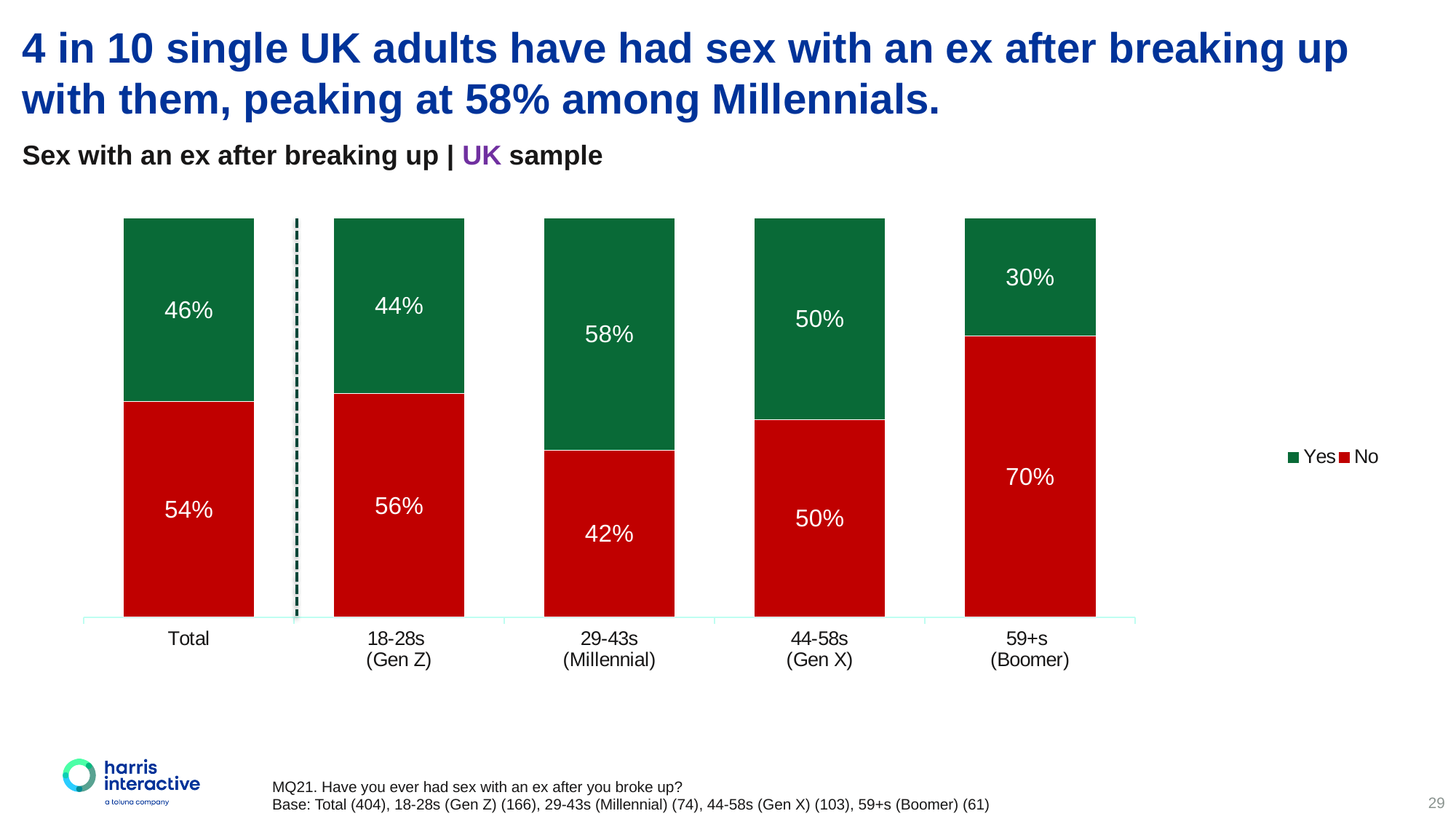
What percentage of the Total group answered Yes? 46% What kind of chart is shown on the slide? Stacked bar chart How many series does the legend list? 2 What is the Yes value for 59+s (Boomer)? 30% Which age group has the highest Yes percentage? 29-43s (Millennial) Which colour represents the No responses in the chart? Red What is the difference between the No percentage for 59+s (Boomer) and the No percentage for 29-43s (Millennial)? 28% Which is larger: the Yes value for 18-28s (Gen Z) or the Yes value for 44-58s (Gen X)? 44-58s (Gen X) What percentage of 29-43s (Millennial) answered No? 42% Which age group has the lowest Yes percentage? 59+s (Boomer) What is the total of the Yes and No segments for the 44-58s (Gen X) bar? 100% How many age-group categories are shown on the x axis, including Total? 5